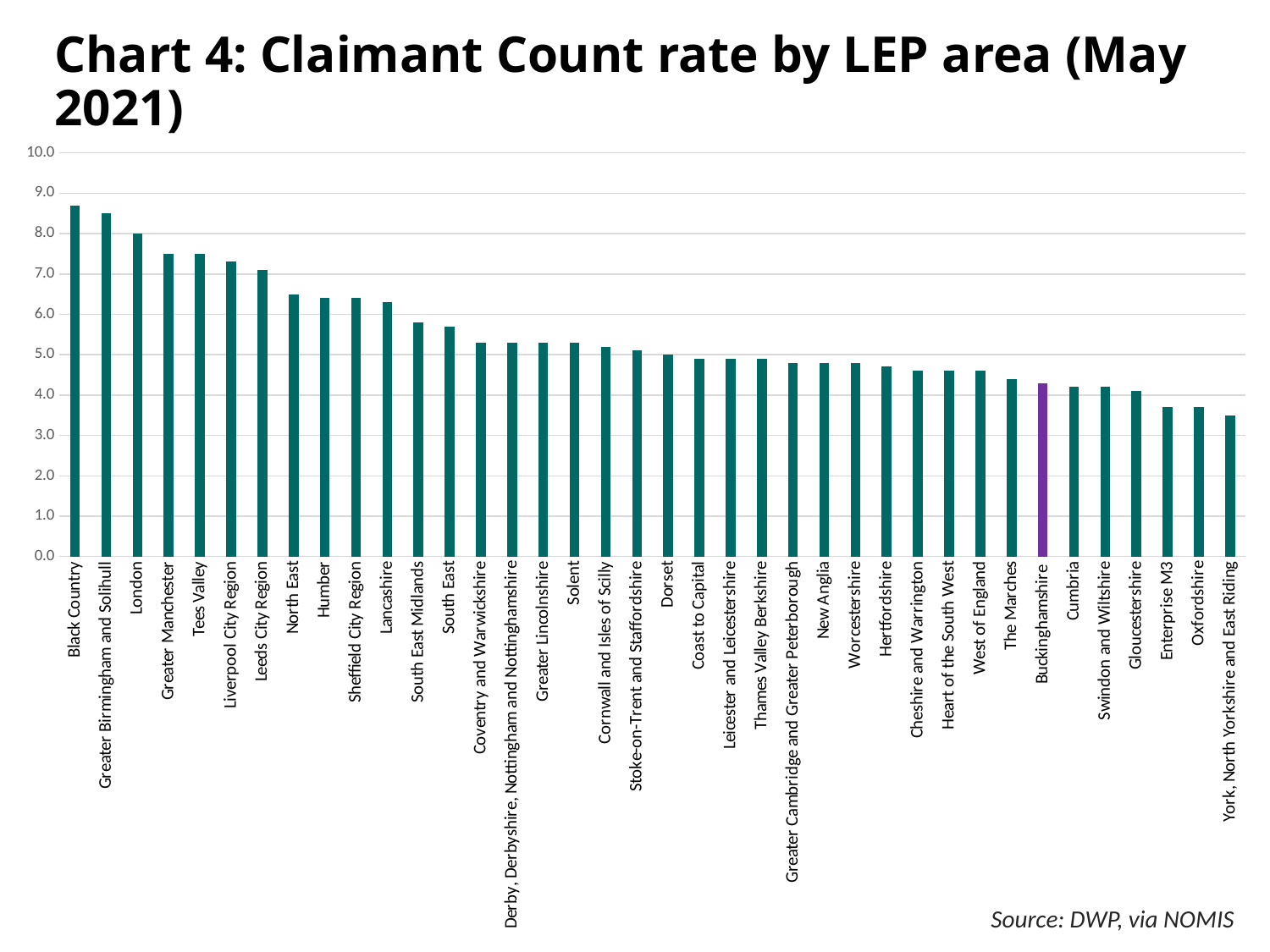
Is the value for Greater Manchester greater or less than 7.0? greater Is the value for Oxfordshire greater or less than 4.0? less Which LEP area has the highest Claimant Count rate? Black Country Is the value for Hertfordshire greater or less than 5.0? less What is the title of the chart? Chart 4: Claimant Count rate by LEP area (May 2021) Do the values rise or fall moving from left to right along the x axis? Fall How many LEP areas are plotted on the chart? 38 Which LEP area's bar is coloured purple rather than green? Buckinghamshire Which LEP area has the lowest Claimant Count rate? York, North Yorkshire and East Riding What kind of chart is shown on the slide? Bar chart Which has the higher Claimant Count rate, Black Country or London? Black Country